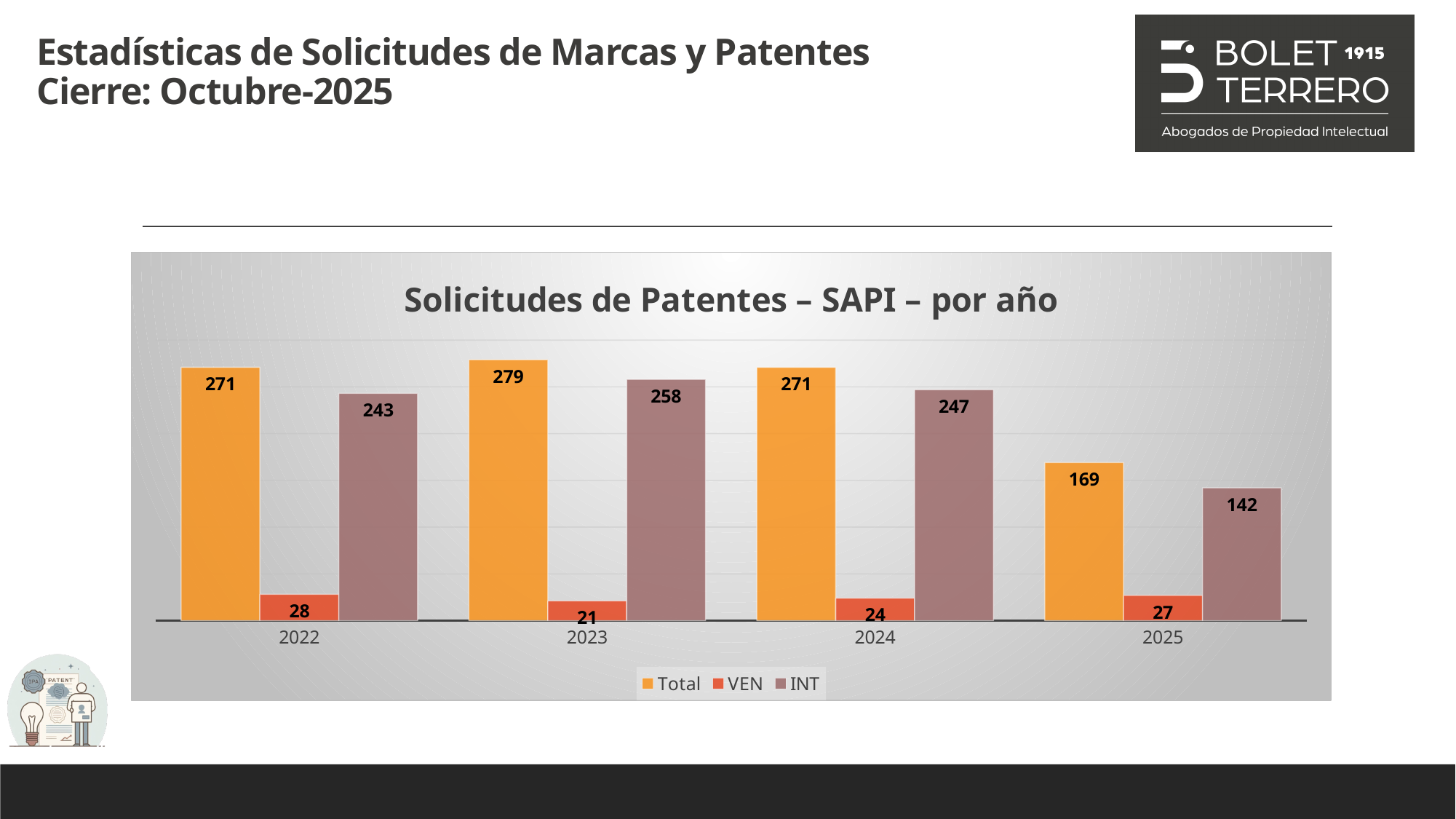
What is the VEN value for 2024? 24 Does the INT series rise or fall from 2023 to 2025? Fall How many series does the legend list? 3 What is the title of the chart? Solicitudes de Patentes – SAPI – por año What is the difference between the Total values for 2024 and 2025? 102 Which year has the highest Total value? 2023 Which year has the lowest INT value? 2025 How many years are shown on the x axis? 4 What kind of chart is shown? Bar chart Which is larger, the VEN value for 2022 or the VEN value for 2023? 2022 What is the INT value for 2025? 142 What is the Total value for 2023? 279